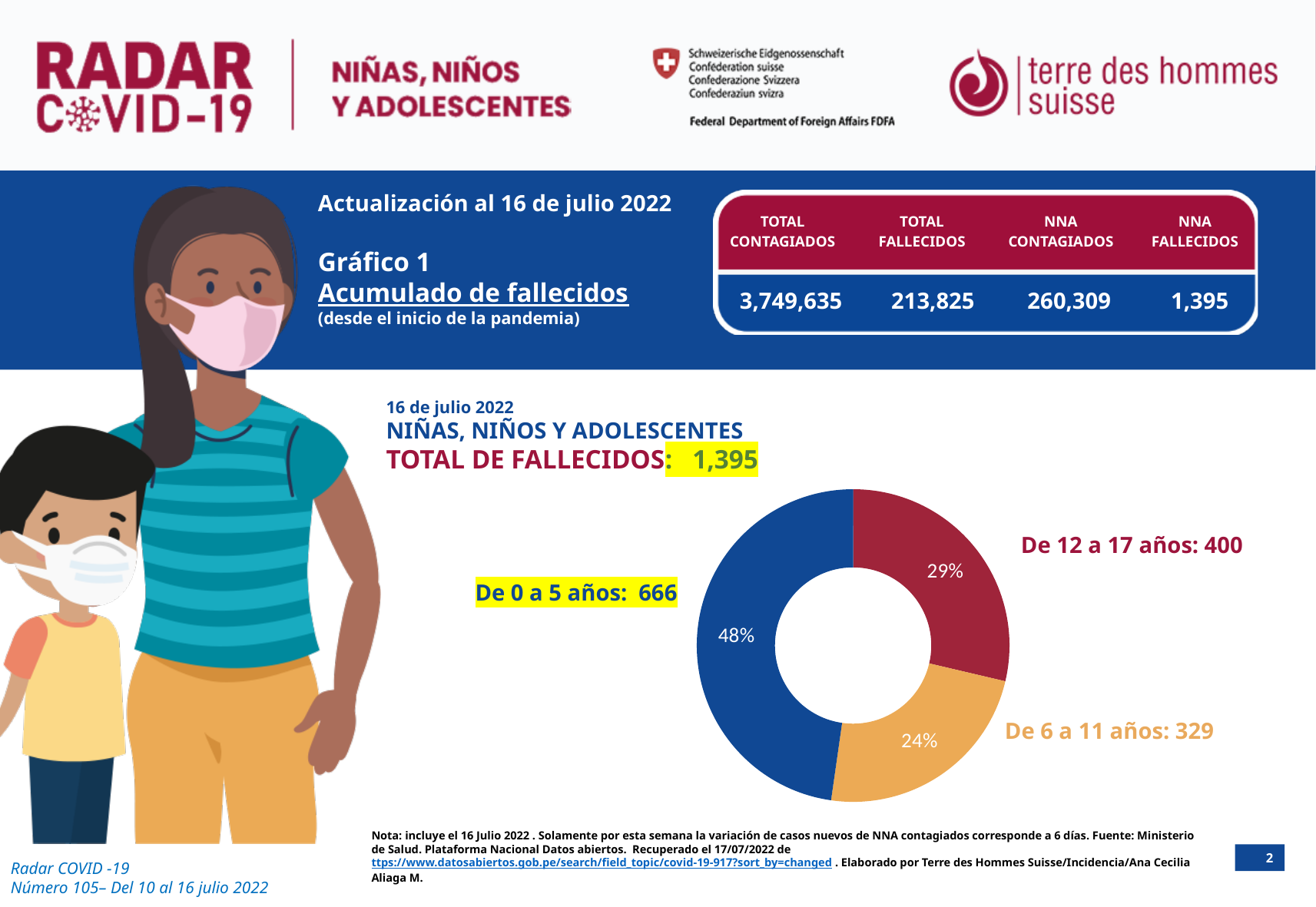
Which age group has the lowest number of deaths in the donut chart? De 6 a 11 años What percentage of the donut chart corresponds to the 'De 0 a 5 años' group? 48% Which age group has the highest number of deaths in the donut chart? De 0 a 5 años What is the total number of deaths shown above the donut chart (TOTAL DE FALLECIDOS)? 1,395 What is the number of deaths for the 'De 0 a 5 años' group? 666 Which group has more deaths, 'De 6 a 11 años' or 'De 12 a 17 años'? De 12 a 17 años What percentage of the donut chart corresponds to the 'De 12 a 17 años' group? 29% What kind of chart is shown on the slide? Donut (pie) chart How many age groups does the donut chart show? 3 What is the difference in deaths between the 'De 0 a 5 años' group and the 'De 12 a 17 años' group? 266 What is the number of deaths for the 'De 12 a 17 años' group? 400 What is the number of deaths for the 'De 6 a 11 años' group? 329